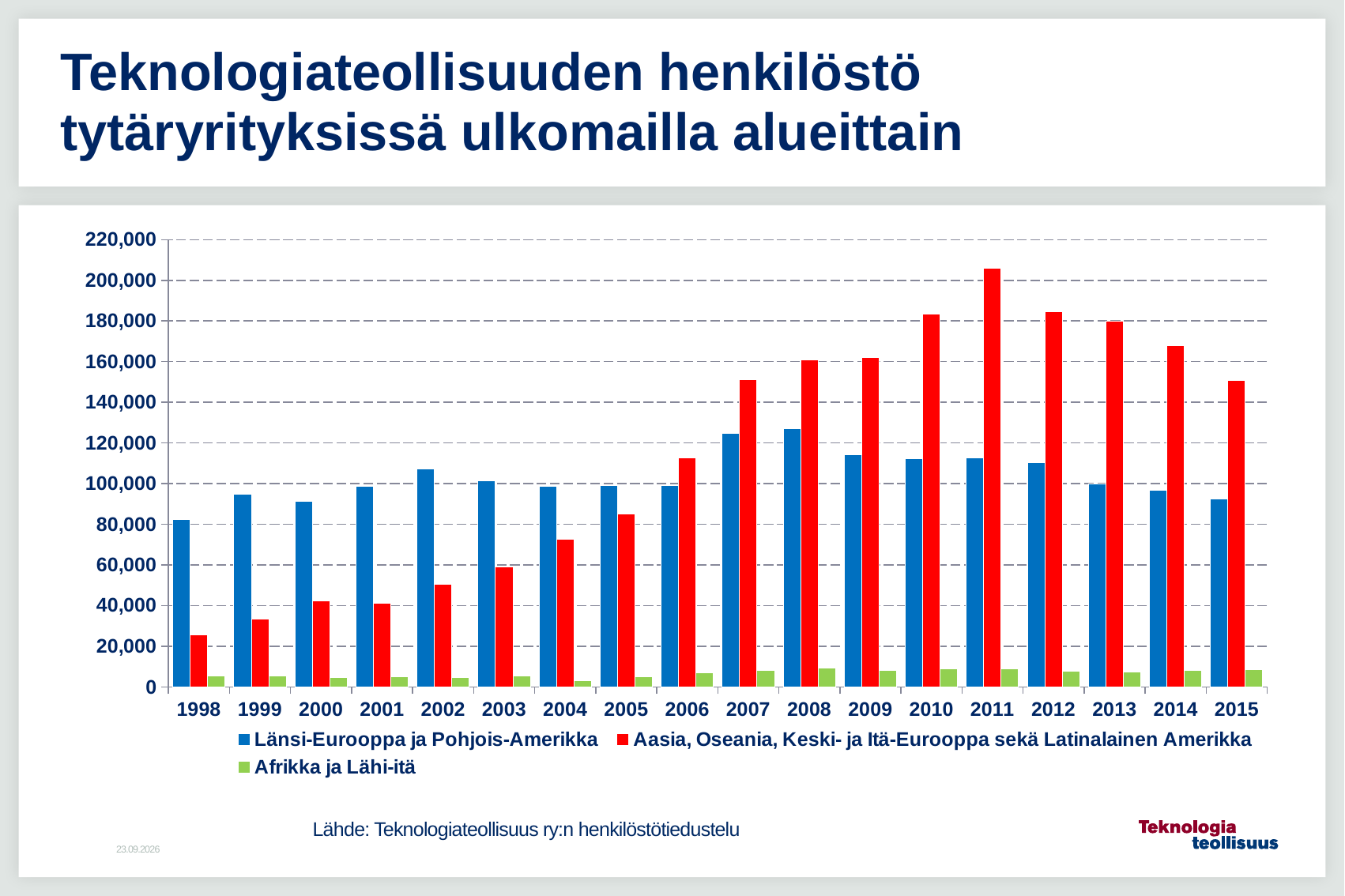
In which year is the value for Aasia, Oseania, Keski- ja Itä-Eurooppa sekä Latinalainen Amerikka highest? 2011 In 2005, which series has the larger value: Länsi-Eurooppa ja Pohjois-Amerikka or Aasia, Oseania, Keski- ja Itä-Eurooppa sekä Latinalainen Amerikka? Länsi-Eurooppa ja Pohjois-Amerikka In which year is the value for Aasia, Oseania, Keski- ja Itä-Eurooppa sekä Latinalainen Amerikka lowest? 1998 How many series does the legend list? 3 What kind of chart is shown on the slide? Bar chart Is the value for Länsi-Eurooppa ja Pohjois-Amerikka in 1998 greater or less than 100,000? less Is the value for Aasia, Oseania, Keski- ja Itä-Eurooppa sekä Latinalainen Amerikka in 2011 greater or less than 200,000? greater How many years are shown on the x axis? 18 Is the value for Aasia, Oseania, Keski- ja Itä-Eurooppa sekä Latinalainen Amerikka in 2007 greater or less than 140,000? greater Does the value for Aasia, Oseania, Keski- ja Itä-Eurooppa sekä Latinalainen Amerikka rise or fall from 1998 to 2011? Rise In which year is the value for Länsi-Eurooppa ja Pohjois-Amerikka lowest? 1998 What colour represents Afrikka ja Lähi-itä in the chart? Green